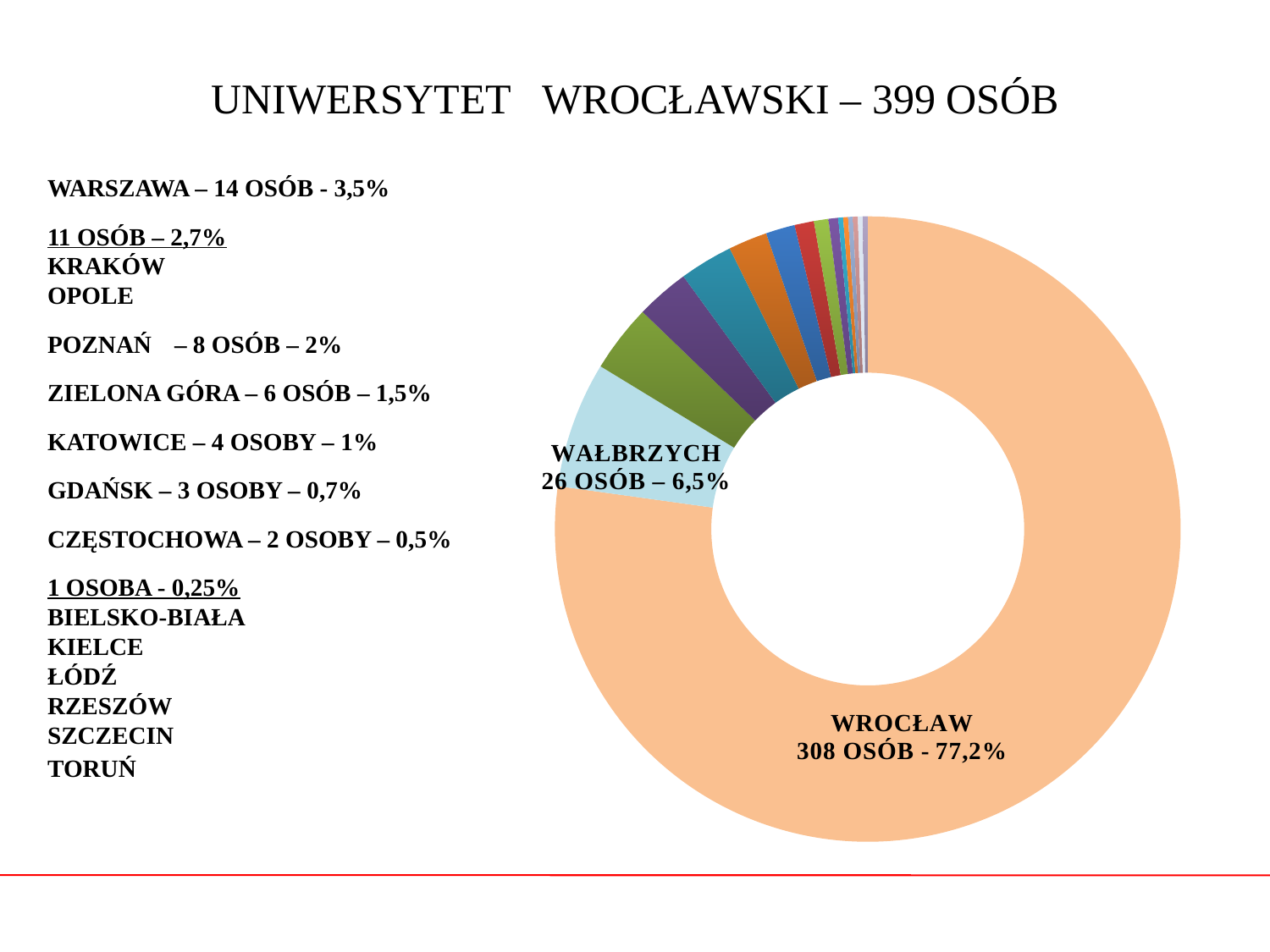
What share of the chart does the Wałbrzych slice take? 6,5% What is the difference in number of people between the Wrocław slice and the Wałbrzych slice? 282 What is the total number of people represented by the chart, according to the slide title? 399 What share of the chart does the Wrocław slice take? 77,2% Is the share of the Wrocław slice greater or less than 50%? greater What kind of chart is shown on the slide? doughnut chart Which is larger, the Wrocław slice or the Wałbrzych slice? Wrocław How many people does the Wałbrzych slice represent? 26 osób How many people does the Wrocław slice represent? 308 osób Which slice of the chart is the largest? Wrocław What colour is the Wrocław slice of the chart? light orange (peach) What is the title of the slide above the chart? UNIWERSYTET WROCŁAWSKI – 399 OSÓB